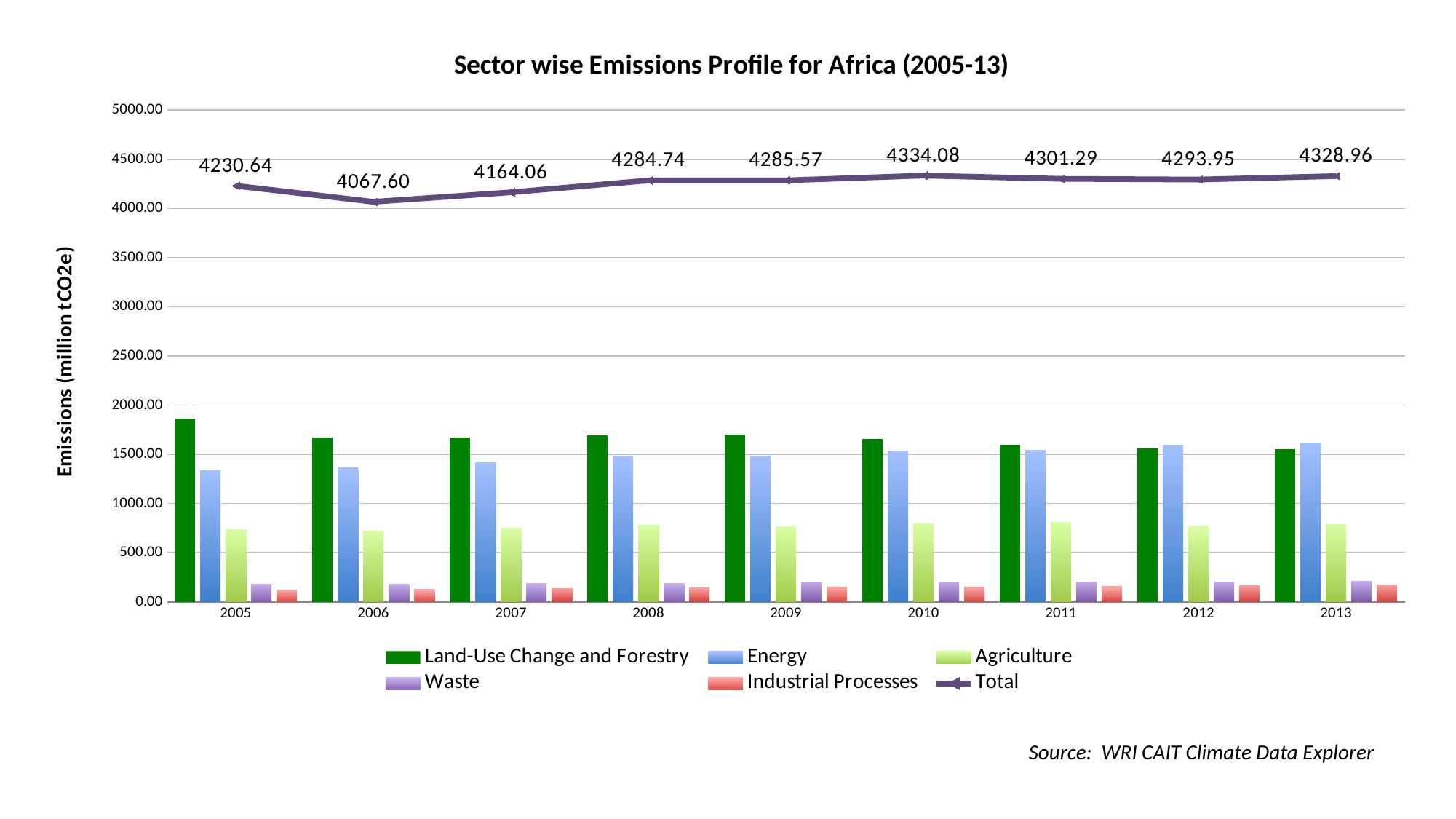
What is the Total emissions value shown for 2010? 4334.08 Is the Land-Use Change and Forestry value for 2005 greater or less than 1500? greater What is the Total emissions value shown for 2013? 4328.96 What is the Total emissions value shown for 2006? 4067.60 Is the Energy value for 2005 greater or less than 1500? less In which year is the Total emissions value the lowest? 2006 What is the difference between the Total emissions in 2013 and in 2005? 98.32 In which year is the Total emissions value the highest? 2010 Which year has the larger Total emissions value, 2011 or 2012? 2011 What is the title of the y axis? Emissions (million tCO2e) How many years are shown on the x axis? 9 How many series does the legend list? 6